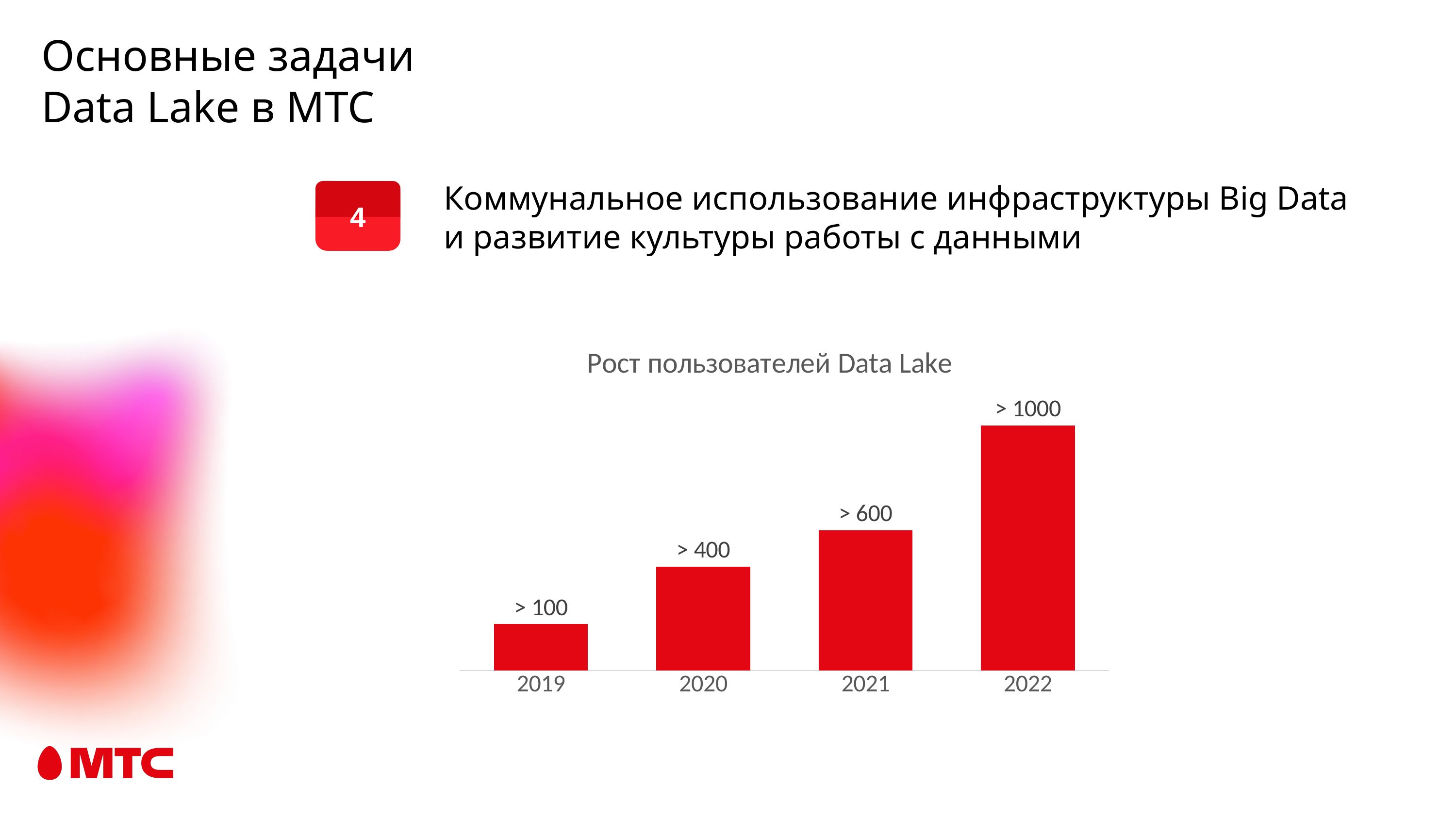
What kind of chart is shown on the slide? Bar chart What is the data label shown for 2022 in the chart? > 1000 What is the data label shown for 2020 in the chart? > 400 Which bar is taller, 2020 or 2021? 2021 What is the data label shown for 2019 in the chart? > 100 What is the title of the chart? Рост пользователей Data Lake Which year has the lowest bar in the chart? 2019 What is the data label shown for 2021 in the chart? > 600 How many bars (years) are shown in the chart? 4 Which year has the highest bar in the chart? 2022 Do the values rise or fall from 2019 to 2022? Rise What colour are the bars in the chart? Red